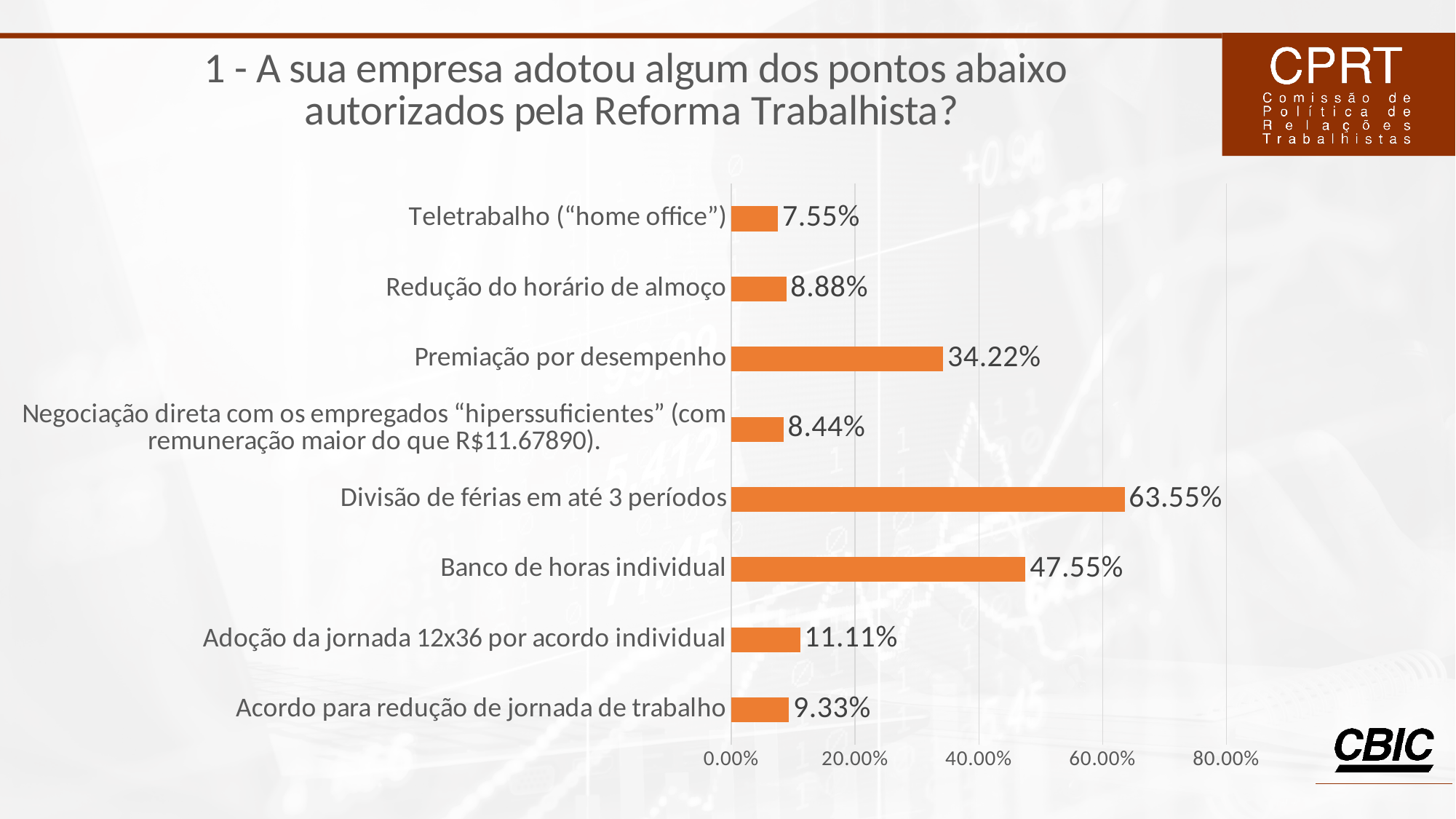
What is the value for "Adoção da jornada 12x36 por acordo individual"? 11.11% Which category has the highest value? Divisão de férias em até 3 períodos What is the highest tick label shown on the value axis? 80.00% Which category has the lowest value? Teletrabalho ("home office") How many categories are shown in the chart? 8 What is the value for "Divisão de férias em até 3 períodos"? 63.55% What is the value for "Teletrabalho ("home office")"? 7.55% What is the value for "Banco de horas individual"? 47.55% What kind of chart is shown on the slide? Bar chart What is the difference between the values for "Divisão de férias em até 3 períodos" and "Banco de horas individual"? 16.00% Is the value for "Banco de horas individual" greater or less than 40.00%? greater Which is larger: the value for "Premiação por desempenho" or the value for "Adoção da jornada 12x36 por acordo individual"? Premiação por desempenho